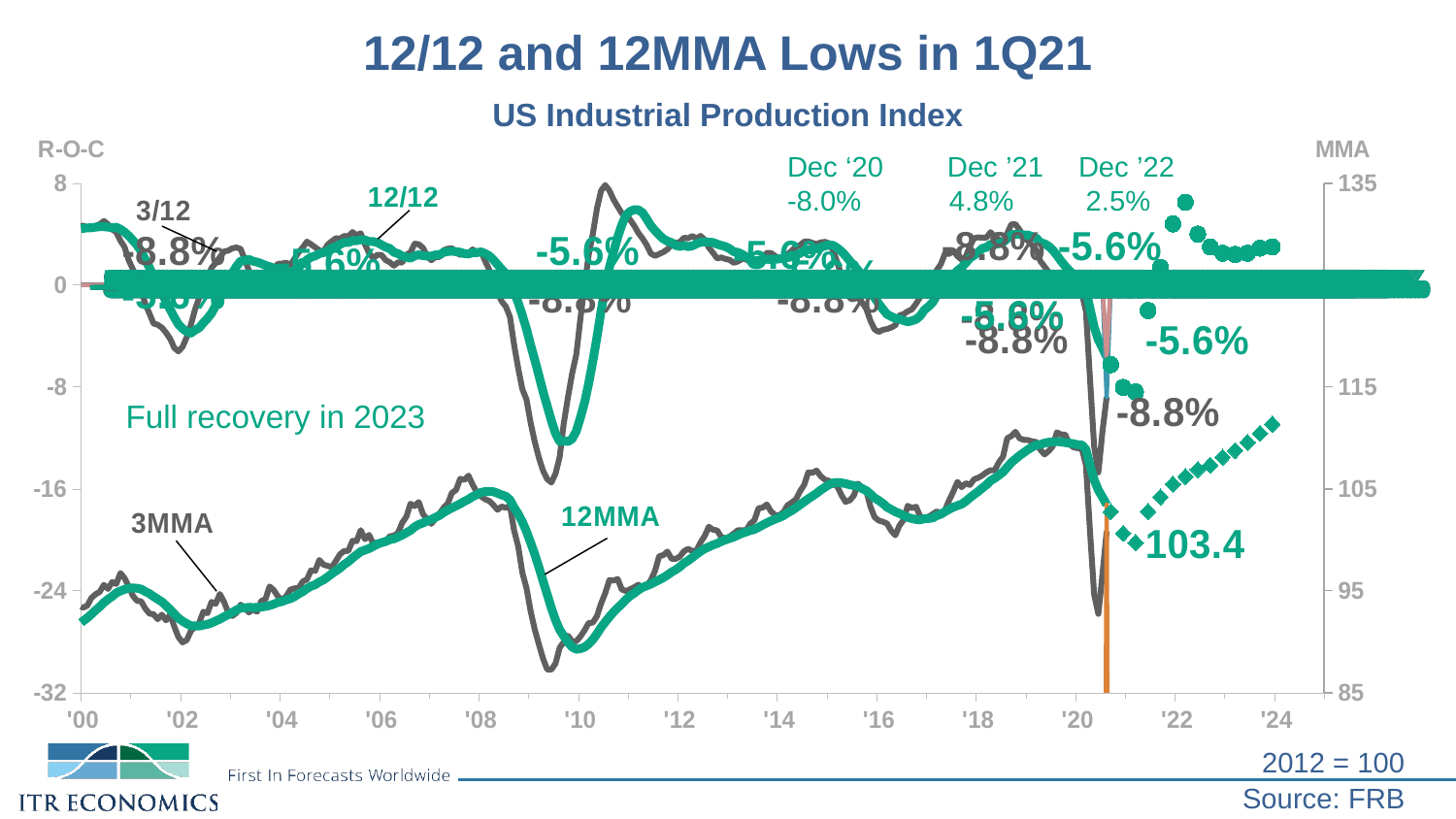
What is the difference between the annotated Dec '21 value (4.8%) and the Dec '22 value (2.5%)? 2.3 percentage points What is the title of the chart? US Industrial Production Index Of the three annotated December values (Dec '20, Dec '21, Dec '22), which is the lowest? Dec '20 What is the source cited for the chart data? FRB What is the annotated value for Dec '21 on the chart? 4.8% Is the annotated Dec '20 value greater or less than 0 on the R-O-C axis? less What 12MMA value is labeled at the low point of the forecast on the chart? 103.4 Which is larger, the annotated value for Dec '21 or for Dec '22? Dec '21 What is the annotated 12/12 value for Dec '20 on the US Industrial Production Index chart? -8.0% What type of chart is shown on the slide? Line chart How many data series are labeled on the chart (3/12, 12/12, 3MMA, 12MMA)? 4 What is the annotated value for Dec '22 on the chart? 2.5%